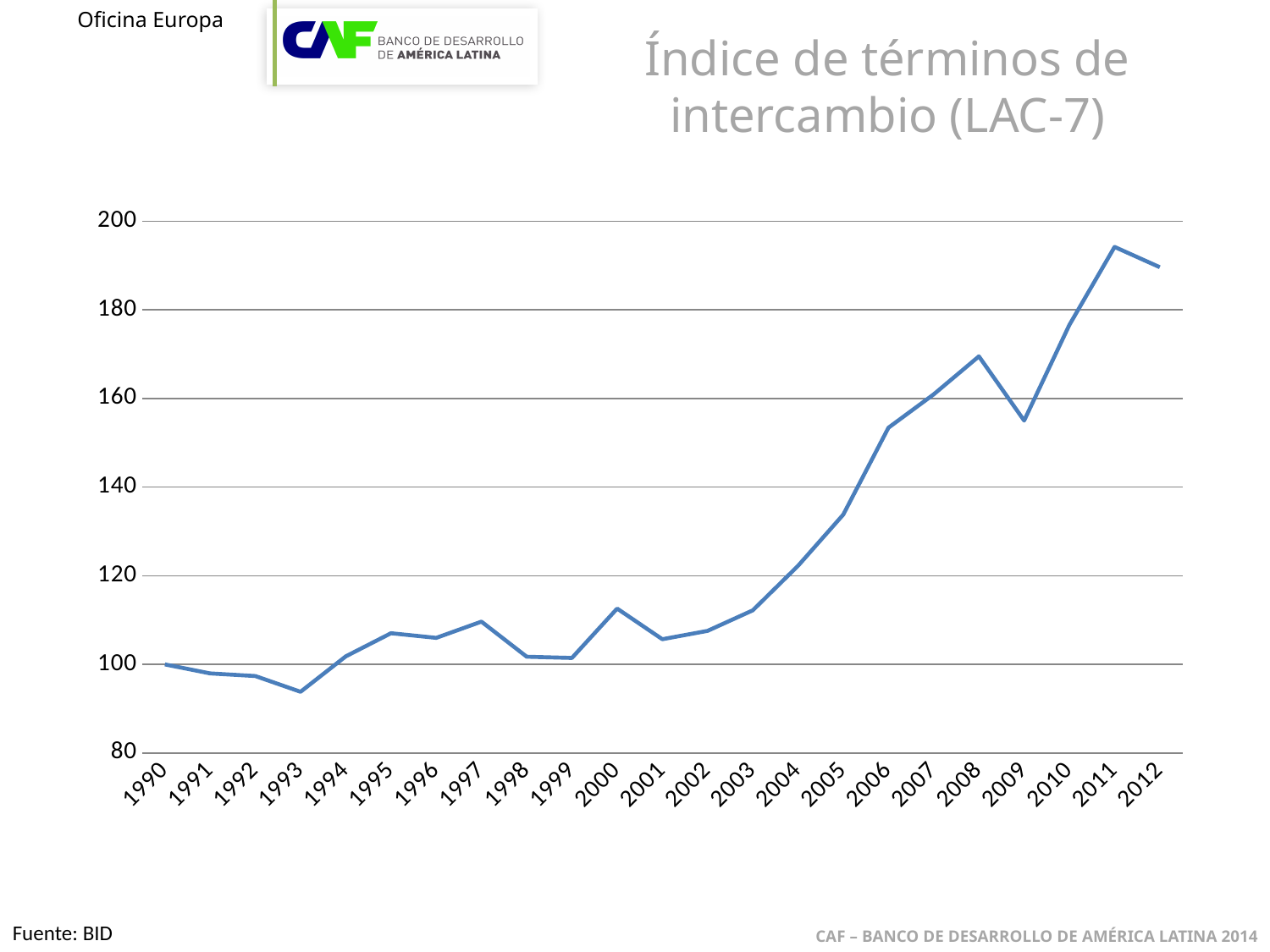
How many years are plotted along the x axis? 23 What is the title of the chart? Índice de términos de intercambio (LAC-7) Is the value for 1993 greater or less than 100? less Does the index generally rise or fall from 1990 to 2012? Rise What source is cited for the chart data? BID Which year has the highest value of the index? 2011 Which year has the larger value, 2008 or 2009? 2008 What kind of chart is shown on the slide? Line chart Is the value for 2006 greater or less than 140? greater Is the value for 2011 greater or less than 180? greater Which year has the lowest value of the index? 1993